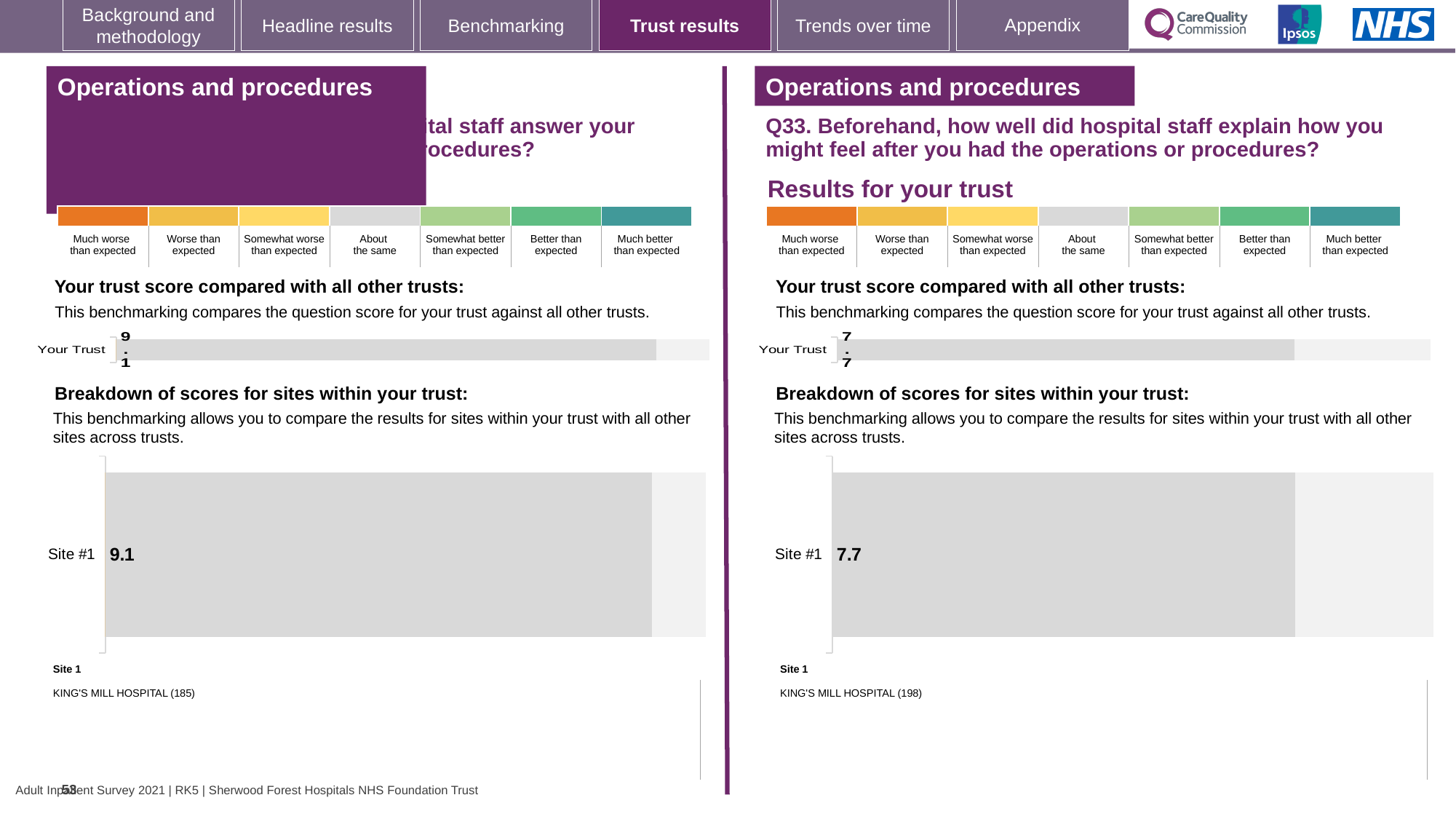
On the right panel (Q33), what is the score shown for Site #1 in the breakdown of scores for sites chart? 7.7 On the left panel, which hospital is listed as Site 1 below the chart? KING'S MILL HOSPITAL (185) On the right panel (Q33), which hospital is listed as Site 1 below the chart? KING'S MILL HOSPITAL (198) What is the difference between the Site #1 score on the left panel and the Site #1 score on the right panel (Q33)? 1.4 How many sites are shown in the breakdown of scores chart on the right panel (Q33)? 1 On the right panel (Q33), what is the value shown for Your Trust in the trust score comparison chart? 7.7 What kind of chart is used to show the Site #1 score on the right panel (Q33)? Bar chart On the right panel (Q33), is the Your Trust score equal to the Site #1 score? Yes On the left panel, what is the value shown for Your Trust in the trust score comparison chart? 9.1 Which panel's Site #1 bar shows the larger score, the left panel or the right panel (Q33)? Left panel How many sites are shown in the breakdown of scores chart on the left panel? 1 On the left panel, what is the score shown for Site #1 in the breakdown of scores for sites chart? 9.1